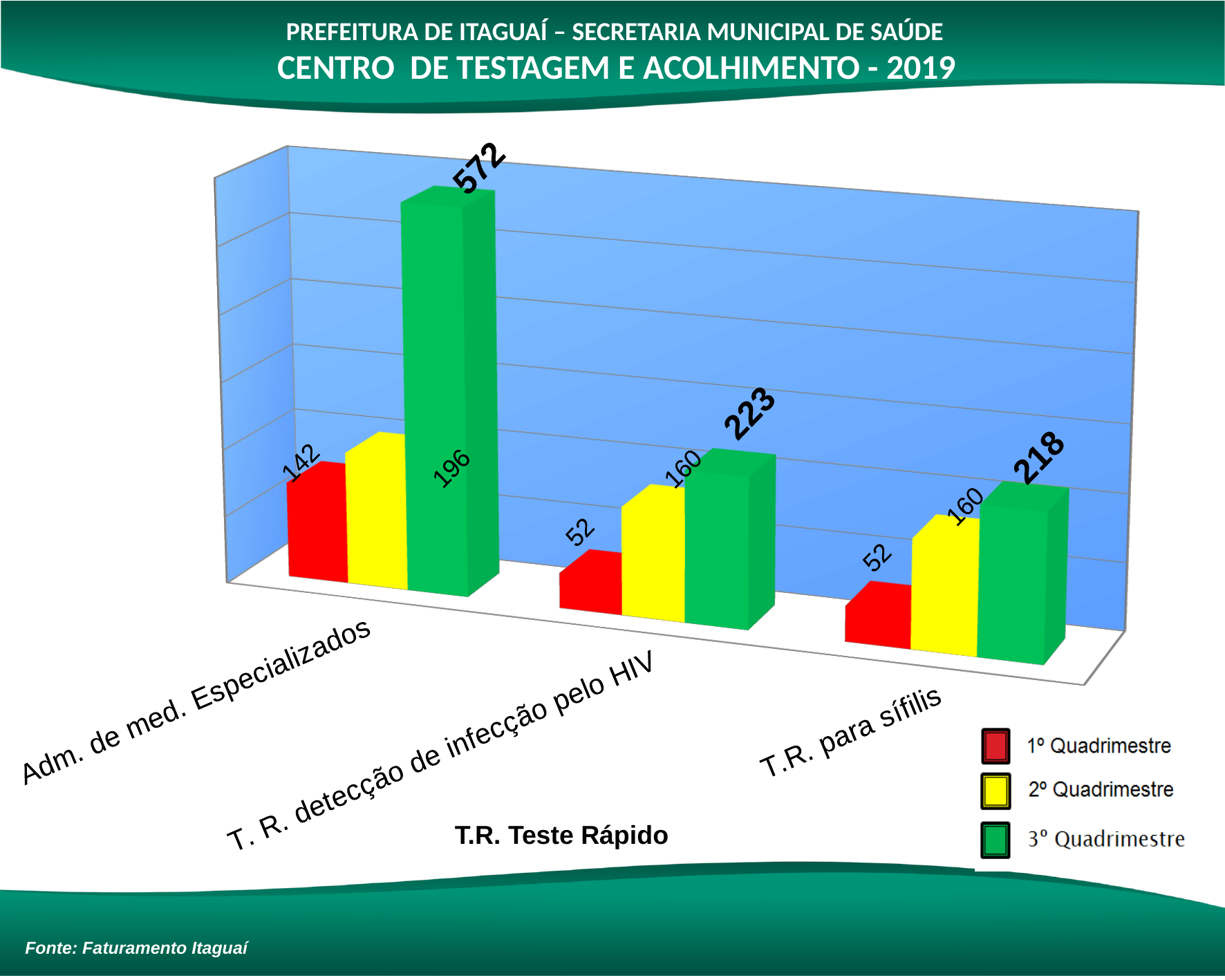
How many categories are shown on the x axis? 3 What is the value for 1º Quadrimestre in the category T. R. detecção de infecção pelo HIV? 52 Which is larger: the 3º Quadrimestre value for T. R. detecção de infecção pelo HIV or for T.R. para sífilis? T. R. detecção de infecção pelo HIV How many series does the legend list? 3 What is the value for 3º Quadrimestre in the category Adm. de med. Especializados? 572 What kind of chart is shown on the slide? bar chart Which colour represents 1º Quadrimestre in the legend? red Which category has the highest value for 3º Quadrimestre? Adm. de med. Especializados What is the difference between the 3º Quadrimestre and 1º Quadrimestre values for Adm. de med. Especializados? 430 What is the value for 2º Quadrimestre in the category T.R. para sífilis? 160 What is the value for 3º Quadrimestre in the category T.R. para sífilis? 218